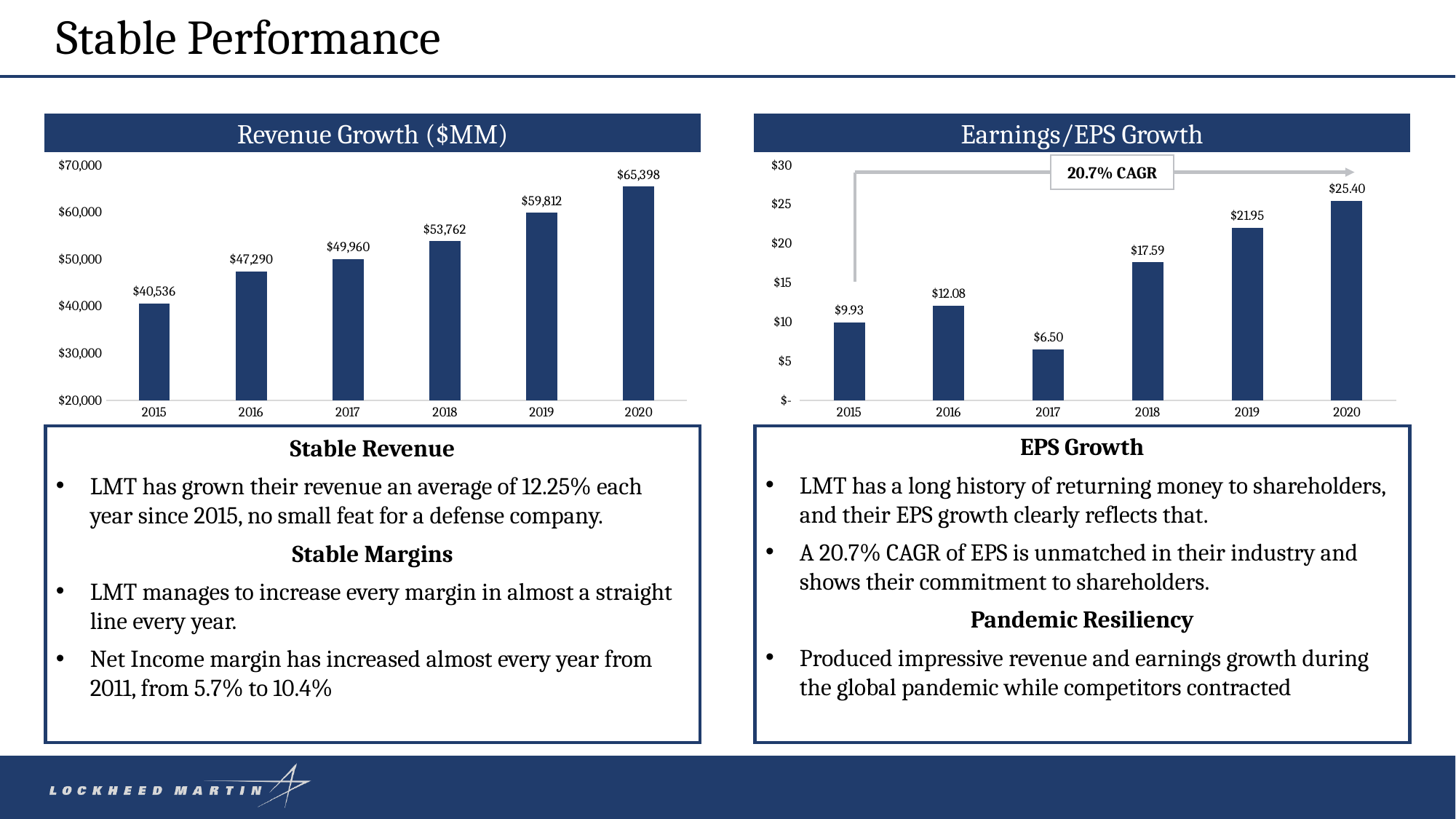
In the Revenue Growth ($MM) chart, do the values rise or fall from 2015 to 2020? rise In the Earnings/EPS Growth chart, what is the difference between the 2019 and 2018 values? $4.36 What kind of chart is the Earnings/EPS Growth chart? bar chart What CAGR is labelled on the Earnings/EPS Growth chart? 20.7% CAGR In the Revenue Growth ($MM) chart, which year has the highest revenue? 2020 In the Earnings/EPS Growth chart, which is larger, the value for 2016 or the value for 2018? 2018 In the Revenue Growth ($MM) chart, what is the value for 2018? $53,762 In the Earnings/EPS Growth chart, what is the value for 2017? $6.50 In the Revenue Growth ($MM) chart, how many years are shown? 6 In the Revenue Growth ($MM) chart, what is the difference between the 2020 and 2015 values? $24,862 In the Earnings/EPS Growth chart, which year has the highest EPS? 2020 In the Earnings/EPS Growth chart, which year has the lowest EPS? 2017